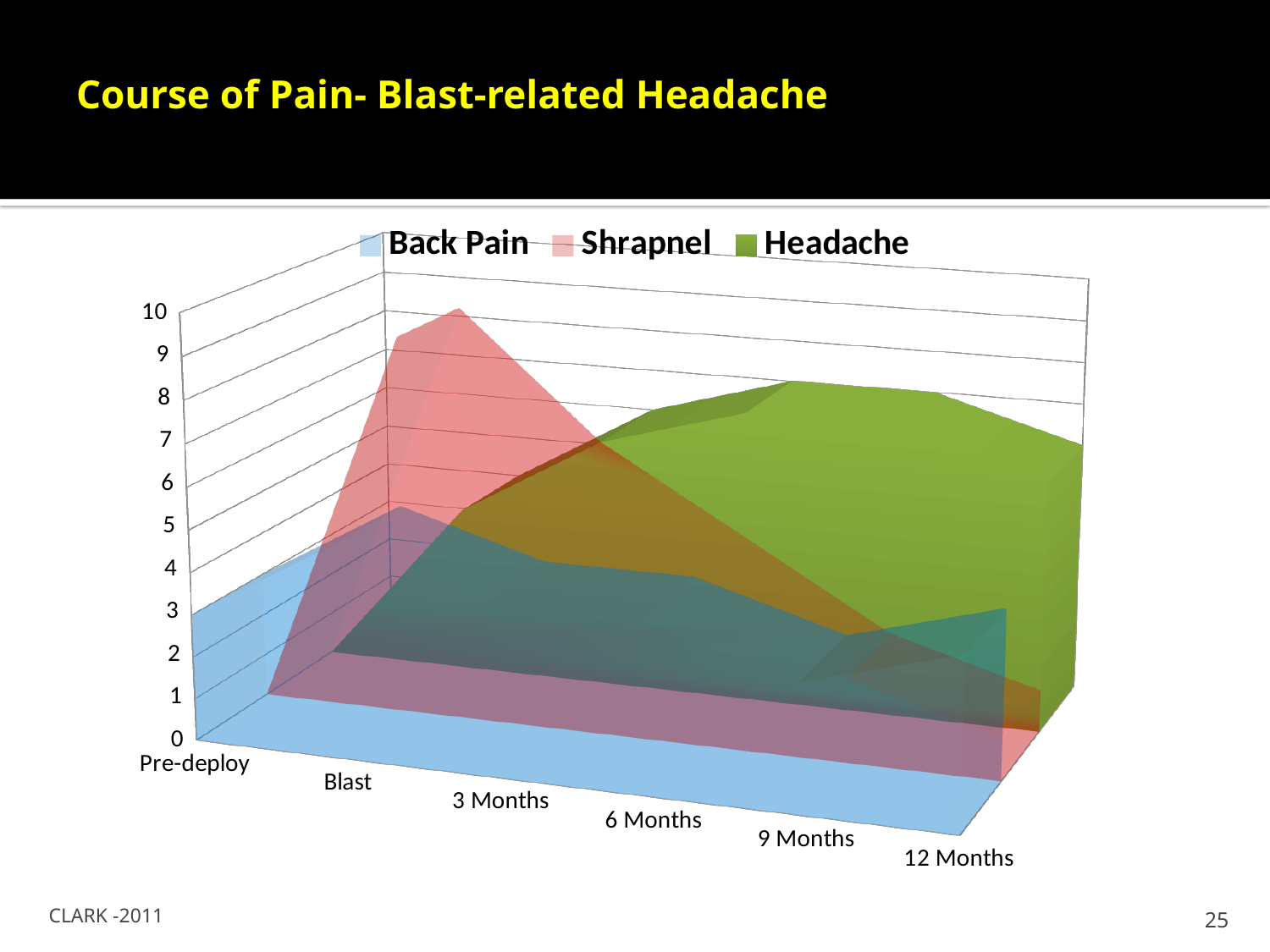
Does the Shrapnel series rise or fall from Blast to 12 Months? Fall Is the Shrapnel value at Blast greater or less than 8? greater How many time points are shown on the x axis? 6 At which time point is the Shrapnel series highest? Blast What kind of chart is shown on the slide? Area chart At which time point is the Headache series lowest? Pre-deploy How many series does the legend list? 3 Which series has the highest value at Blast? Shrapnel Which colour represents the Headache series in the legend? Green Is the Back Pain value at Pre-deploy greater or less than 5? less Is the Headache value at Pre-deploy greater or less than 2? less